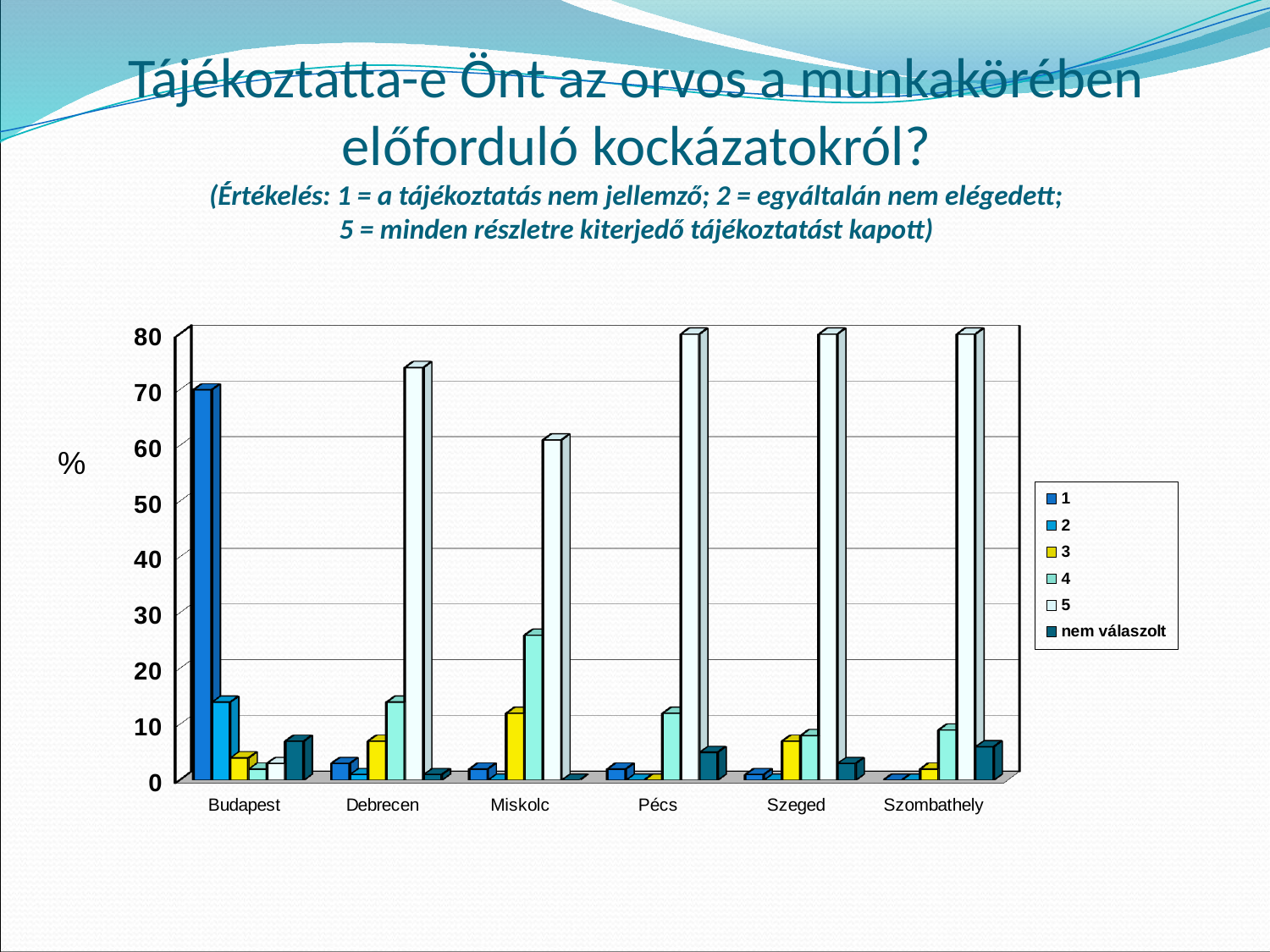
How many series does the chart's legend list? 6 Is the value for series 5 in Pécs greater or less than 70? greater What kind of chart is shown on the slide? bar chart Is the value for series 1 in Budapest greater or less than 60? greater Which city has the highest bar for series 1? Budapest Which city has the larger bar for series 4: Miskolc or Debrecen? Miskolc How many cities are shown on the x axis of the chart? 6 Which is larger in Budapest: the bar for series 1 or the bar for series 2? series 1 Is the value for series 4 in Miskolc greater or less than 20? greater Which city has the lowest bar for series 5? Budapest